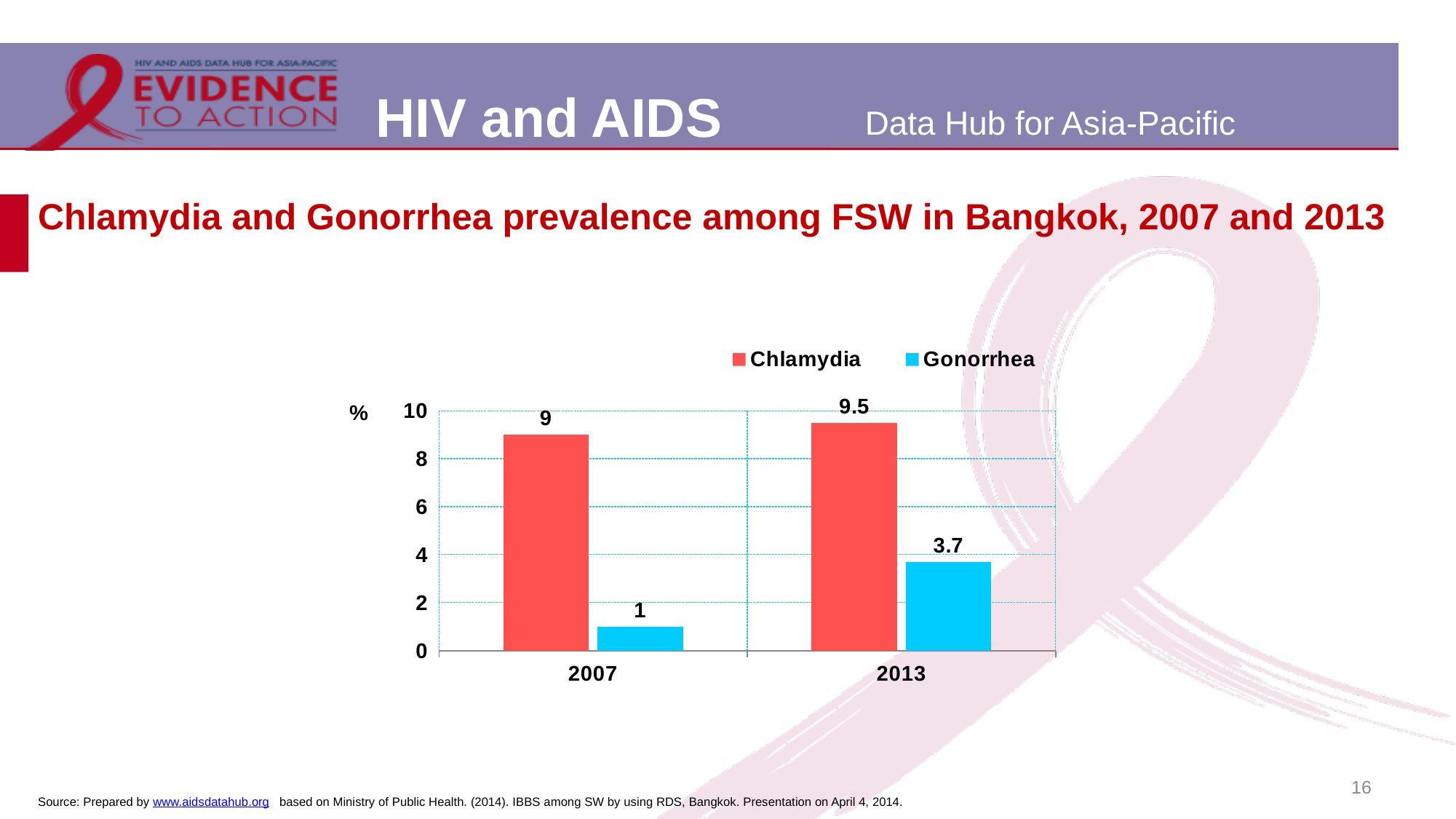
What is the Chlamydia value for 2013? 9.5 What is the Gonorrhea value for 2007? 1 Which year has the higher Chlamydia prevalence? 2013 By how much did Gonorrhea prevalence change from 2007 to 2013? 2.7 What is the difference between the Chlamydia and Gonorrhea values in 2013? 5.8 Which year has the lower Gonorrhea prevalence? 2007 Which colour represents Gonorrhea in the chart? Blue What is the Chlamydia prevalence among FSW in Bangkok in 2007? 9 Is the Chlamydia value for 2007 greater or less than the Gonorrhea value for 2013? greater What kind of chart is shown on the slide? Bar chart What is the Gonorrhea prevalence among FSW in Bangkok in 2013? 3.7 How many series does the legend list? 2